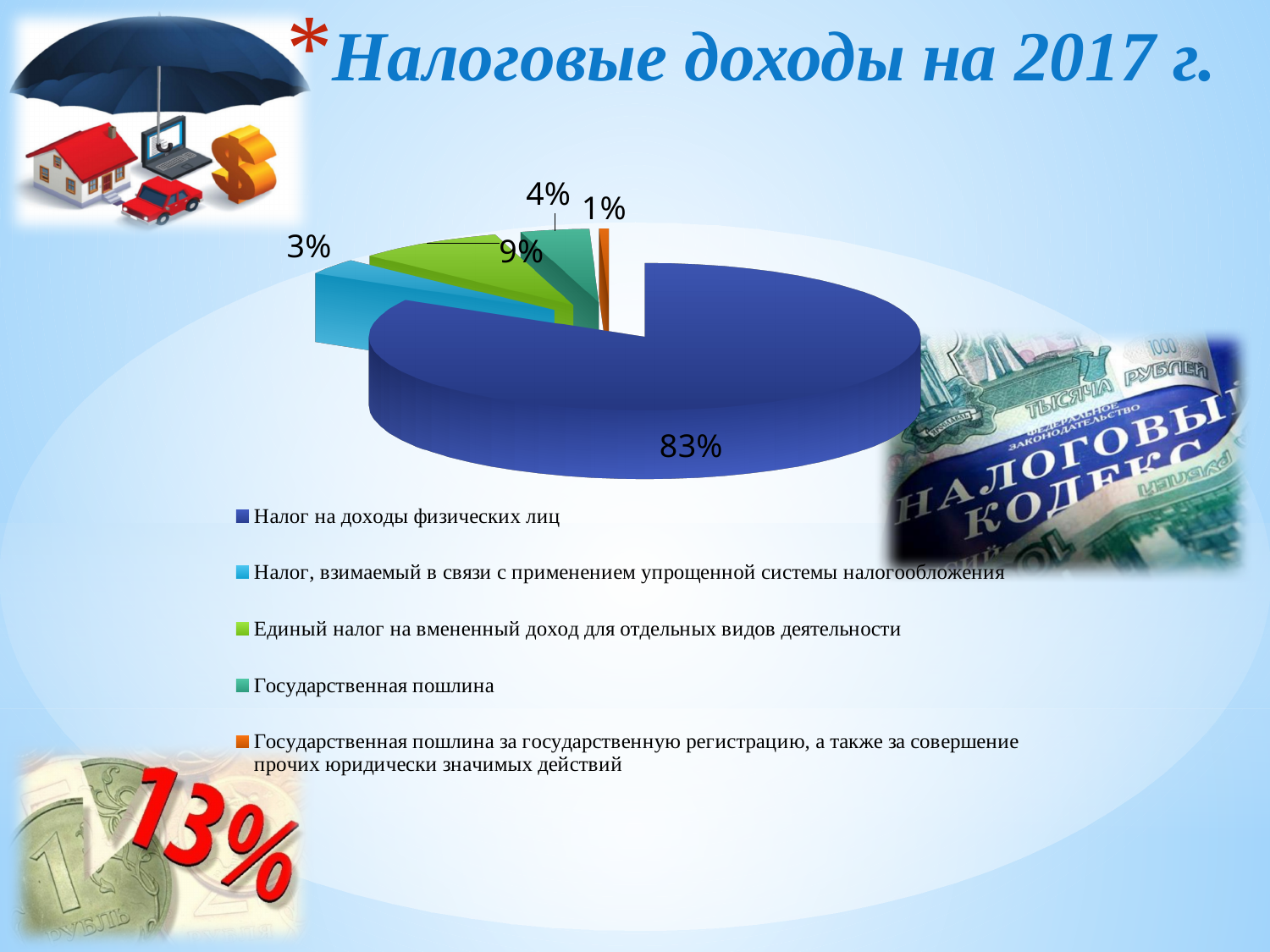
What share of the pie does "Государственная пошлина за государственную регистрацию, а также за совершение прочих юридически значимых действий" have? 1% Which category has the largest slice of the pie? Налог на доходы физических лиц Which category has the smallest slice of the pie? Государственная пошлина за государственную регистрацию, а также за совершение прочих юридически значимых действий What is the difference in percentage points between "Единый налог на вмененный доход для отдельных видов деятельности" and "Государственная пошлина"? 5% What share of the pie does "Налог, взимаемый в связи с применением упрощенной системы налогообложения" have? 3% What share of the pie does "Государственная пошлина" have? 4% How many categories does the legend list? 5 What kind of chart is shown on the slide? pie chart Which is larger: the share for "Государственная пошлина" or the share for "Налог, взимаемый в связи с применением упрощенной системы налогообложения"? Государственная пошлина What is the title of the chart slide? Налоговые доходы на 2017 г.